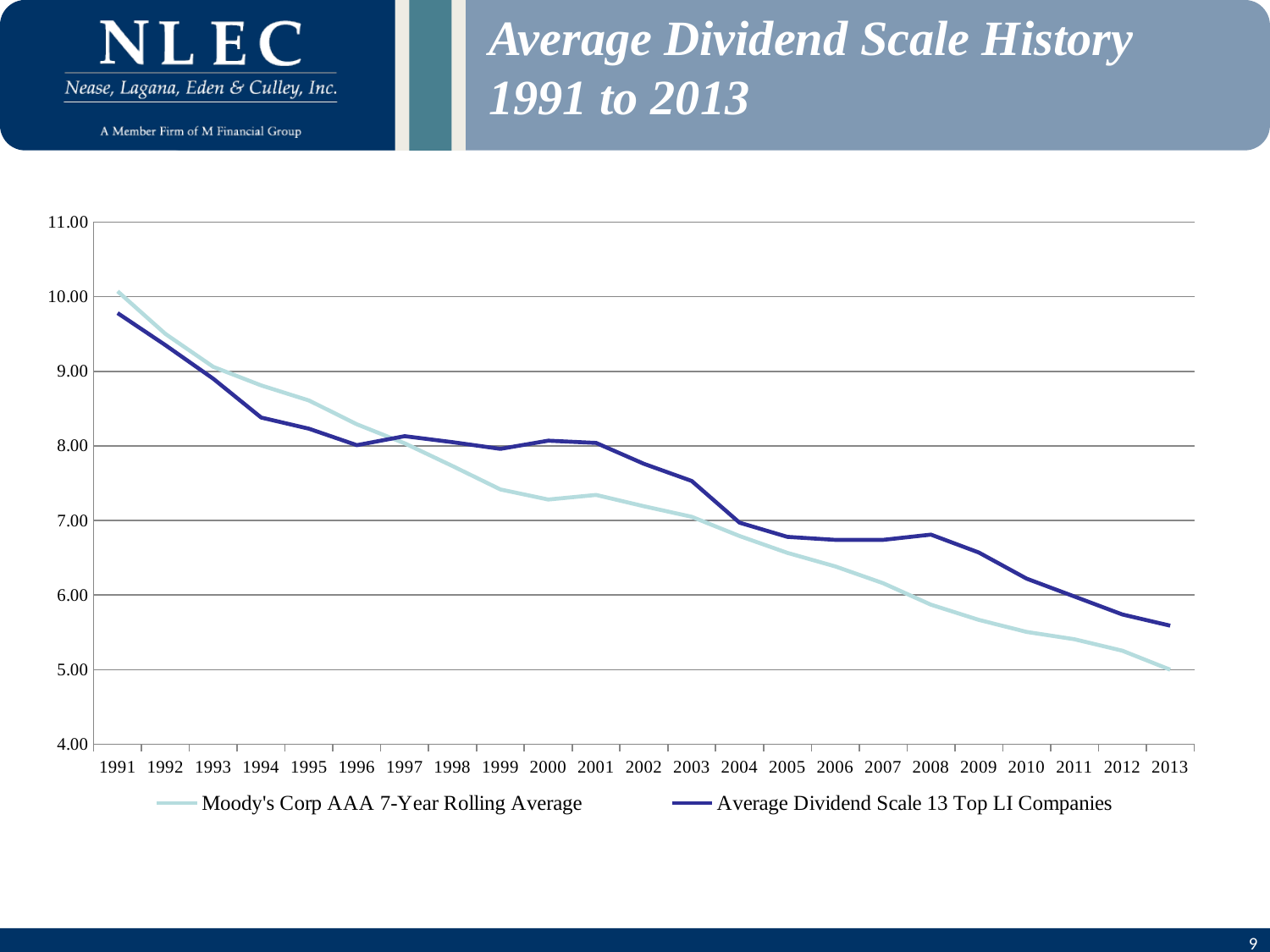
What kind of chart is shown on the slide? Line chart How many years are plotted along the x axis? 23 Do the values for Average Dividend Scale 13 Top LI Companies generally rise or fall from 1991 to 2013? Fall What is the title of the chart on the slide? Average Dividend Scale History 1991 to 2013 Is the value for Average Dividend Scale 13 Top LI Companies in 2013 greater or less than 6.00? less Which series is drawn with the dark blue line? Average Dividend Scale 13 Top LI Companies In which year is the Average Dividend Scale 13 Top LI Companies lowest? 2013 In which year is the Moody's Corp AAA 7-Year Rolling Average highest? 1991 Is the value for Average Dividend Scale 13 Top LI Companies in 2003 greater or less than 7.00? greater Is the value for Moody's Corp AAA 7-Year Rolling Average in 1991 greater or less than 9.00? greater How many series does the legend list? 2 In 2008, which series has the higher value: Moody's Corp AAA 7-Year Rolling Average or Average Dividend Scale 13 Top LI Companies? Average Dividend Scale 13 Top LI Companies